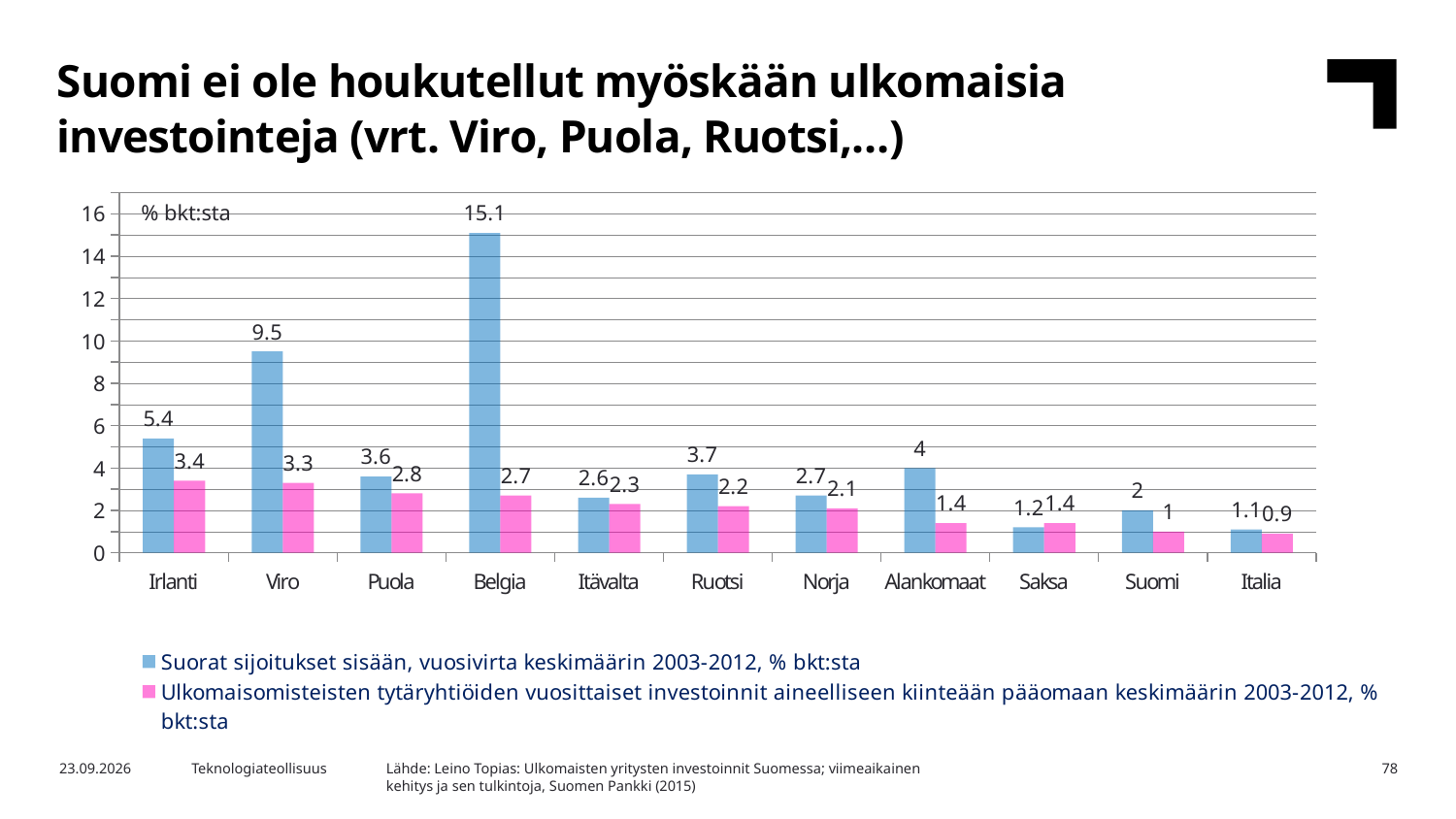
Which country has the lowest value in the series 'Ulkomaisomisteisten tytäryhtiöiden vuosittaiset investoinnit aineelliseen kiinteään pääomaan keskimäärin 2003-2012, % bkt:sta'? Italia What unit label is printed at the top left of the chart's plot area? % bkt:sta What is the difference between Viro and Suomi in the series 'Suorat sijoitukset sisään, vuosivirta keskimäärin 2003-2012, % bkt:sta'? 7.5 How many series does the chart's legend list? 2 Which country has the highest value in the series 'Suorat sijoitukset sisään, vuosivirta keskimäärin 2003-2012, % bkt:sta'? Belgia Which is larger in the series 'Suorat sijoitukset sisään, vuosivirta keskimäärin 2003-2012, % bkt:sta': Irlanti or Alankomaat? Irlanti What kind of chart is shown on the slide? Bar chart How many countries are shown on the x axis of the chart? 11 What is the value for Ruotsi in the series 'Suorat sijoitukset sisään, vuosivirta keskimäärin 2003-2012, % bkt:sta'? 3.7 What is the value for Suomi in the series 'Ulkomaisomisteisten tytäryhtiöiden vuosittaiset investoinnit aineelliseen kiinteään pääomaan keskimäärin 2003-2012, % bkt:sta'? 1 What is the value for Belgia in the series 'Suorat sijoitukset sisään, vuosivirta keskimäärin 2003-2012, % bkt:sta'? 15.1 What is the difference between the two series' values for Irlanti? 2